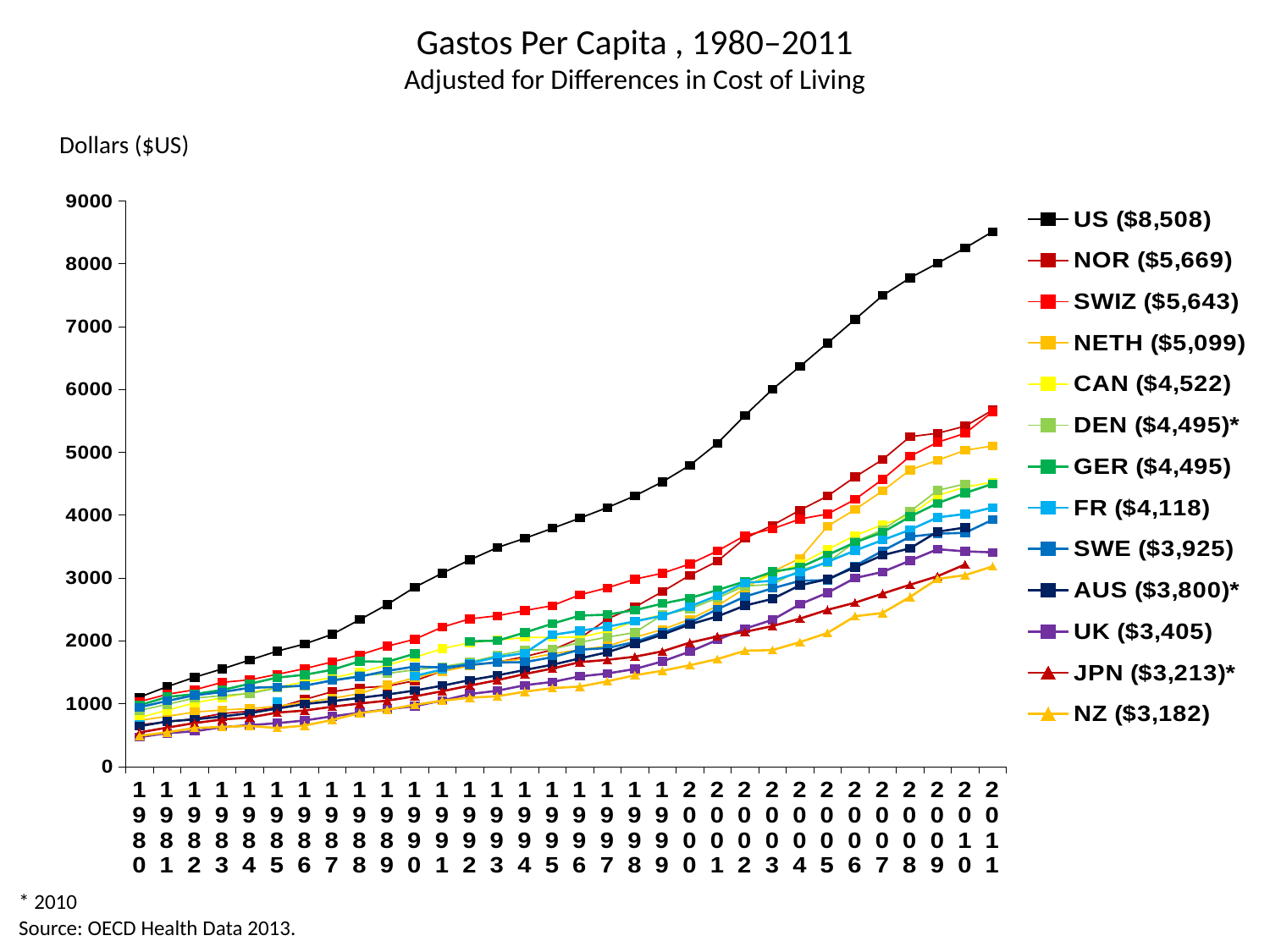
What unit label is shown above the y axis? Dollars ($US) Does the US line rise or fall from 1980 to 2011? rise What is the difference between the US value ($8,508) and the NOR value ($5,669) shown in the legend? $2,839 What per capita spending value is shown for NOR in the legend? $5,669 Is the value for the US in 1995 greater or less than 3000? greater Which country has the highest per capita spending value in the legend? US Which has the larger legend value, SWIZ or NETH? SWIZ What per capita spending value is shown for the US in the legend? $8,508 Which country has the lowest per capita spending value in the legend? NZ How many years are plotted along the x axis? 32 What kind of chart is shown on the slide? line chart How many series (countries) does the legend list? 13